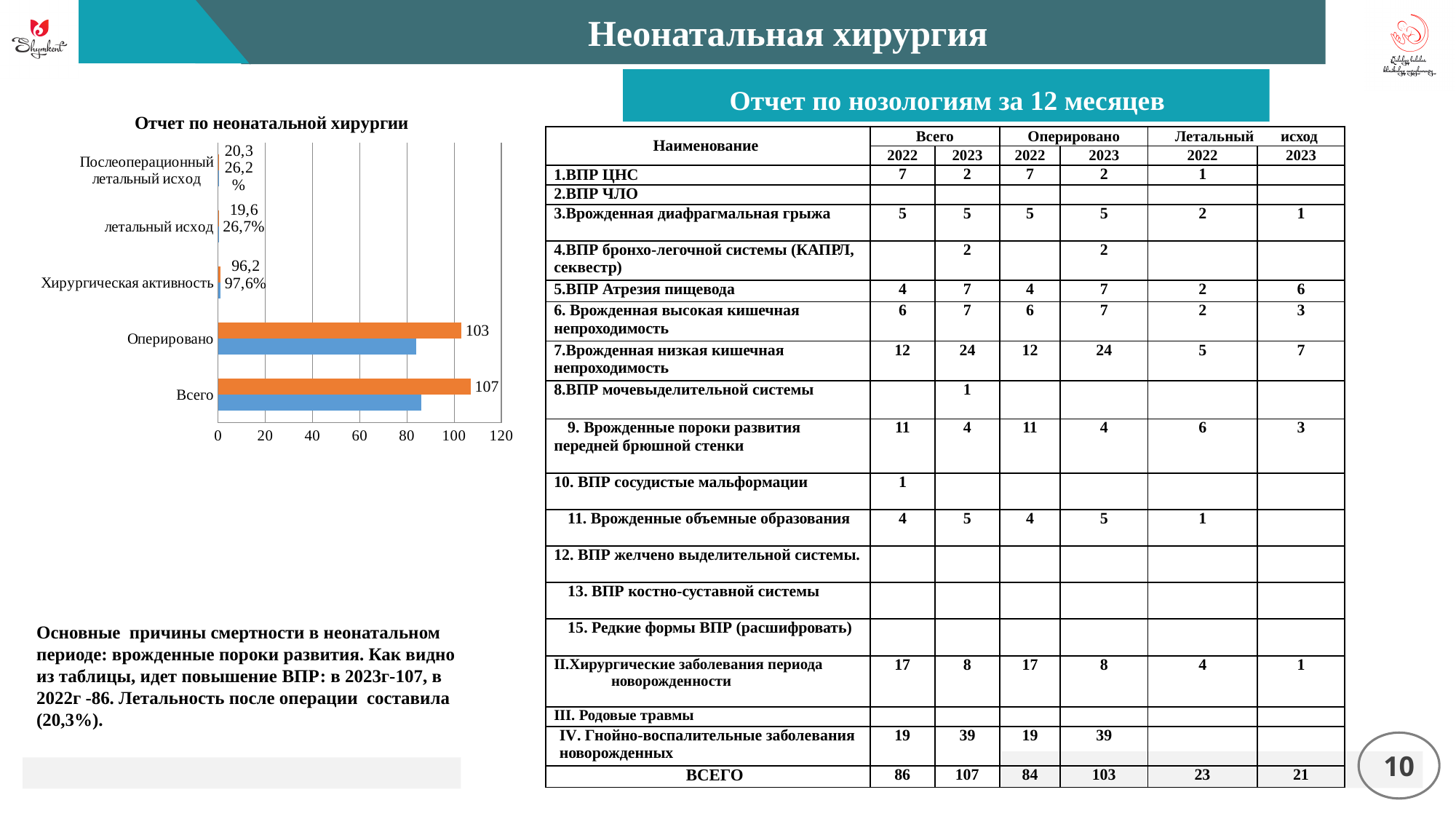
Which category has the longest bar on the chart? Всего Which is larger: the orange bar for "Всего" or the orange bar for "Оперировано"? Всего What is the difference between the orange bar values for "Всего" and "Оперировано"? 4 What is the maximum value shown on the chart's horizontal axis? 120 What value is labelled on the orange bar for "Оперировано"? 103 What value is labelled on the orange bar for "Всего"? 107 What is the title of the chart on the left of the slide? Отчет по неонатальной хирургии What two data labels are shown for "Хирургическая активность"? 96,2 and 97,6% What kind of chart is shown on the slide? Bar chart How many categories are shown on the chart's vertical axis? 5 Is the value of the blue bar for "Всего" greater or less than 80? greater Is the value of the blue bar for "Оперировано" greater or less than 60? greater